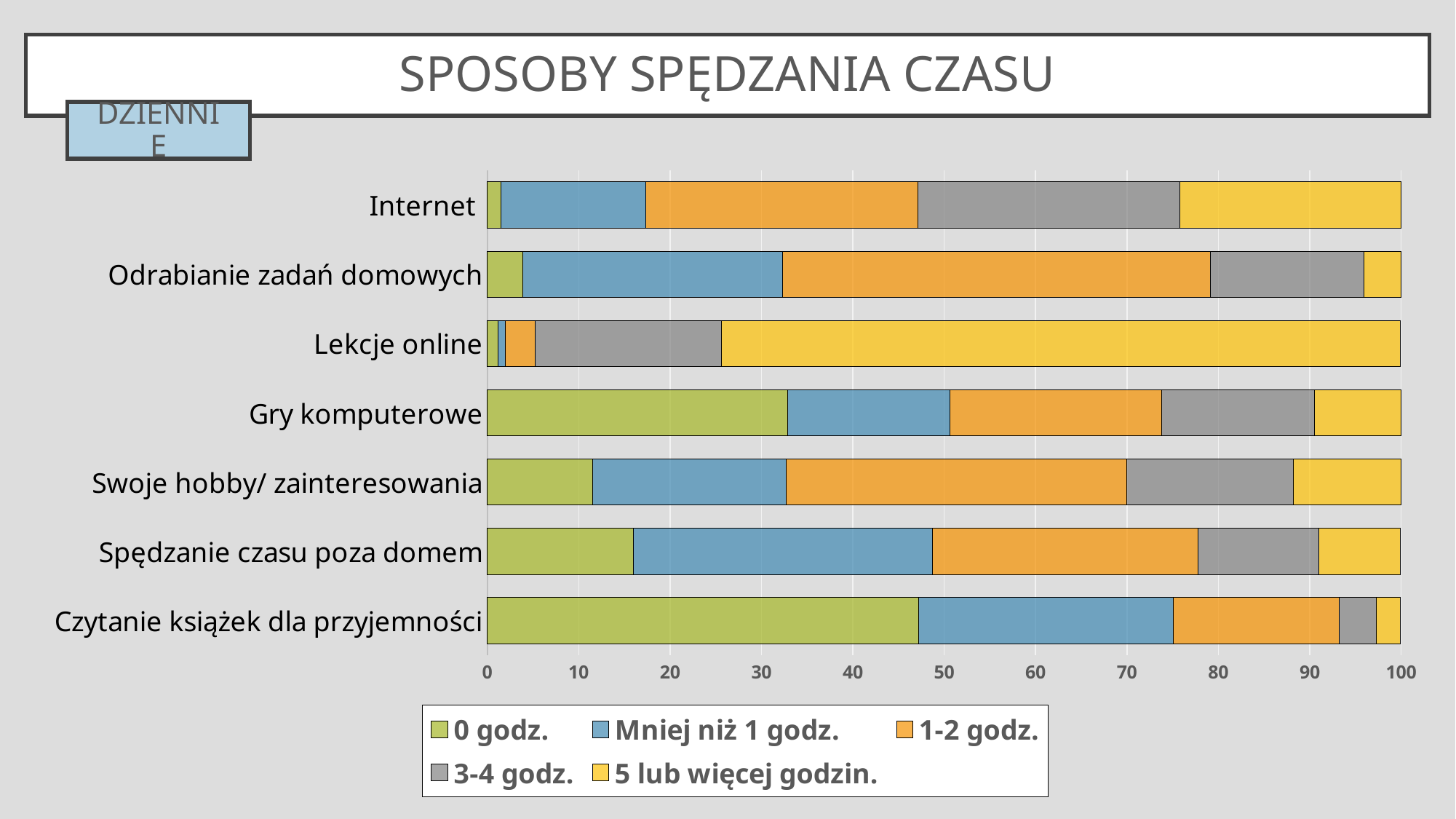
Which category has the largest '5 lub więcej godzin.' segment? Lekcje online Which category has the largest '1-2 godz.' segment? Odrabianie zadań domowych Which is larger: the '0 godz.' segment for Gry komputerowe or for Internet? Gry komputerowe Is the '0 godz.' value for Internet greater or less than 10? less Which legend entry is shown in yellow? 5 lub więcej godzin. What kind of chart is shown on the slide? Stacked bar chart What is the title of the slide containing the chart? SPOSOBY SPĘDZANIA CZASU Is the '5 lub więcej godzin.' value for Lekcje online greater or less than 70? greater Which category has the largest '0 godz.' segment? Czytanie książek dla przyjemności Is the '0 godz.' value for Czytanie książek dla przyjemności greater or less than 40? greater How many series does the legend list? 5 How many categories (activities) are plotted on the chart? 7